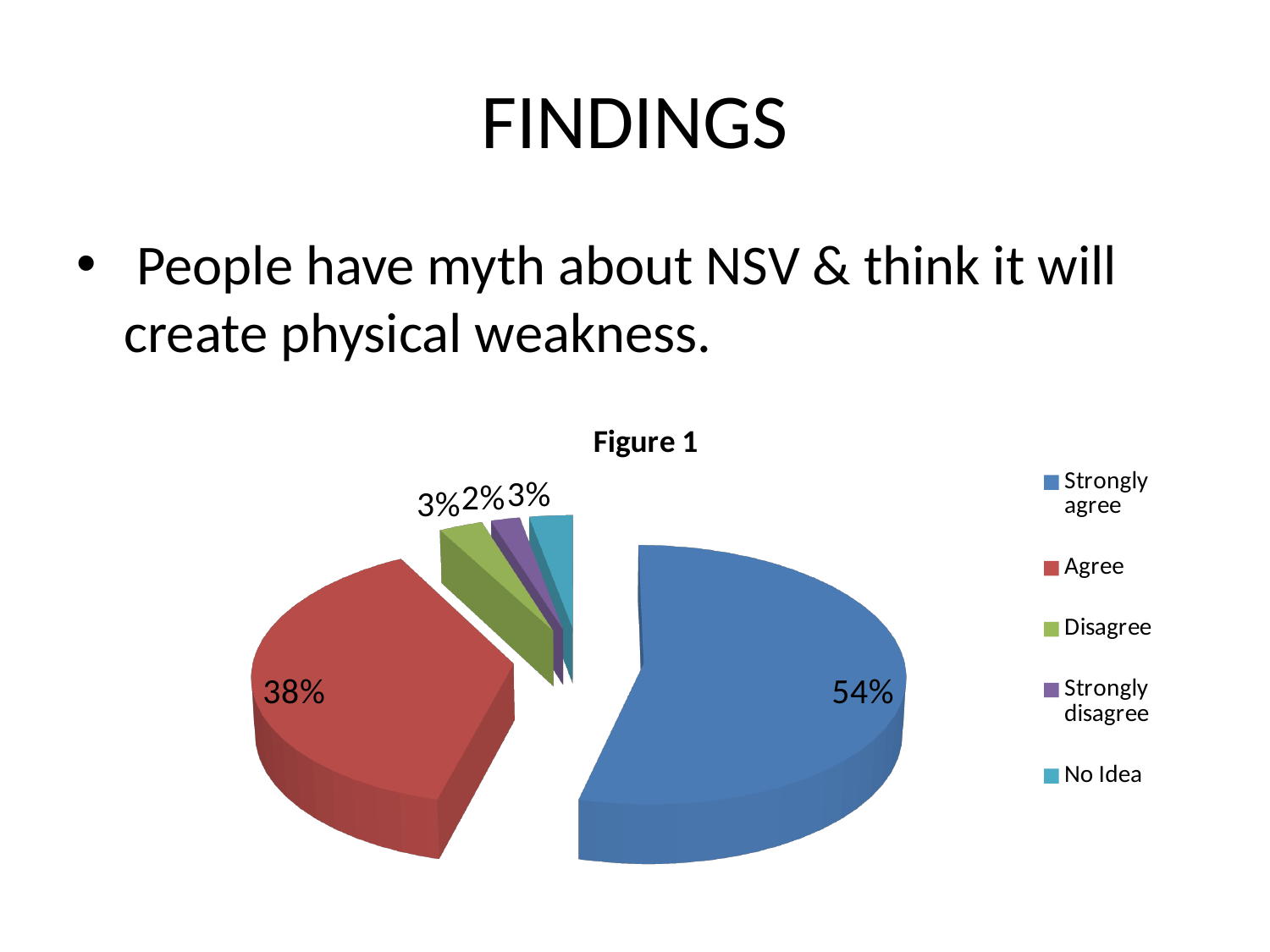
What is the difference in percentage points between "Strongly agree" and "Agree"? 16 What percentage of the pie is labelled for "Disagree"? 3% What colour is the slice for "Agree"? red What percentage of the pie is labelled for "Strongly disagree"? 2% Which category has the smallest slice of the pie? Strongly disagree What kind of chart is shown under the title "Figure 1"? pie chart Which is larger, the slice for "Agree" or the slice for "Disagree"? Agree What percentage of the pie is labelled for "Agree"? 38% What is the title of the chart? Figure 1 What percentage of the pie is labelled for "Strongly agree"? 54% Which category has the largest slice of the pie? Strongly agree How many categories does the legend of the pie chart list? 5